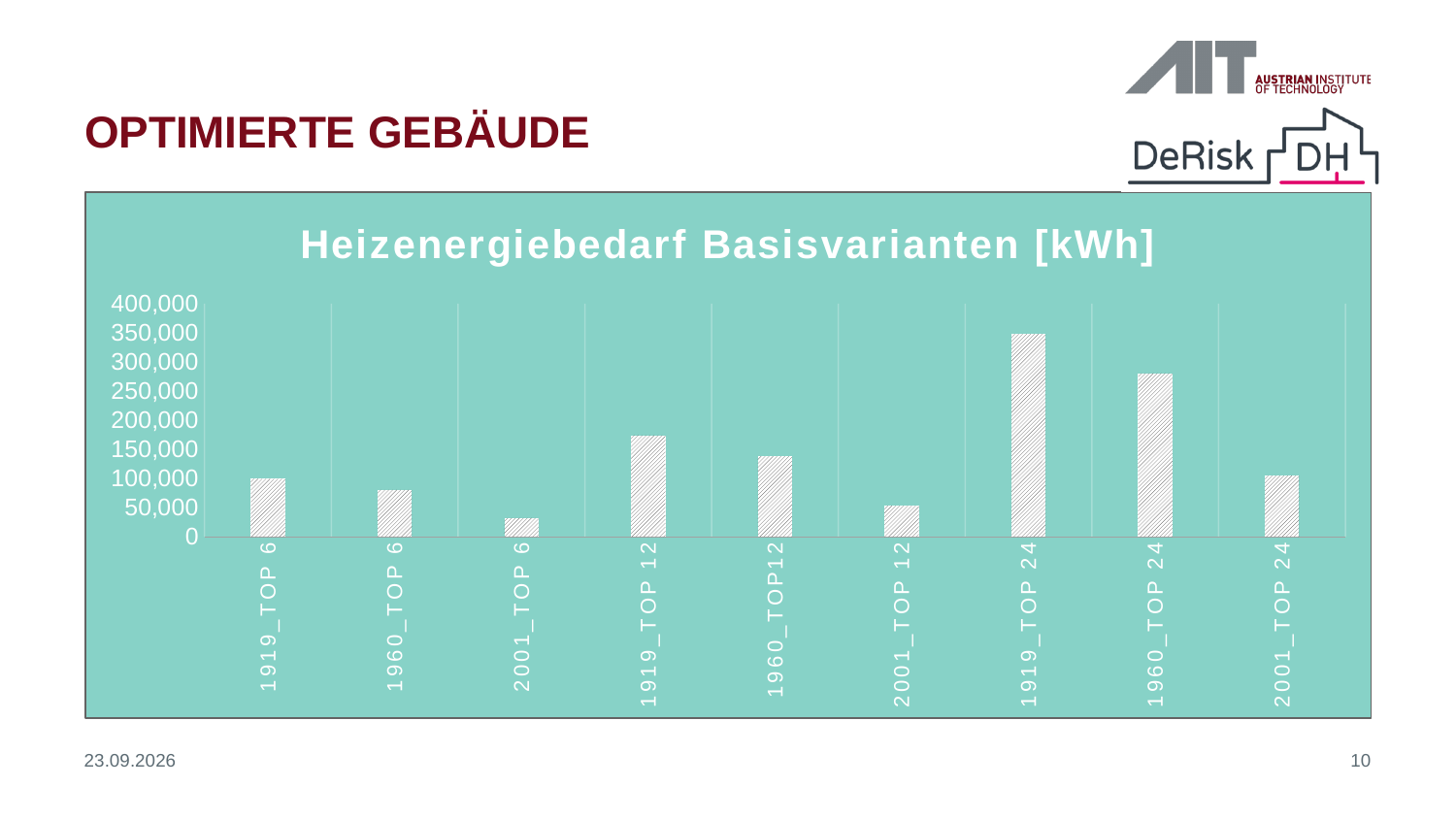
Which category has the lowest Heizenergiebedarf? 2001_TOP 6 Which category has the highest Heizenergiebedarf? 1919_TOP 24 Which is larger, the value for 1919_TOP 12 or 2001_TOP 12? 1919_TOP 12 What is the title of the chart? Heizenergiebedarf Basisvarianten [kWh] Is the value for 1919_TOP 24 greater or less than 300,000? greater Which is larger, the value for 1919_TOP 24 or 1960_TOP 24? 1919_TOP 24 What type of chart is shown on the slide? bar chart Is the value for 1960_TOP 24 greater or less than 250,000? greater How many categories are plotted in the chart? 9 Is the value for 1960_TOP 6 greater or less than 100,000? less